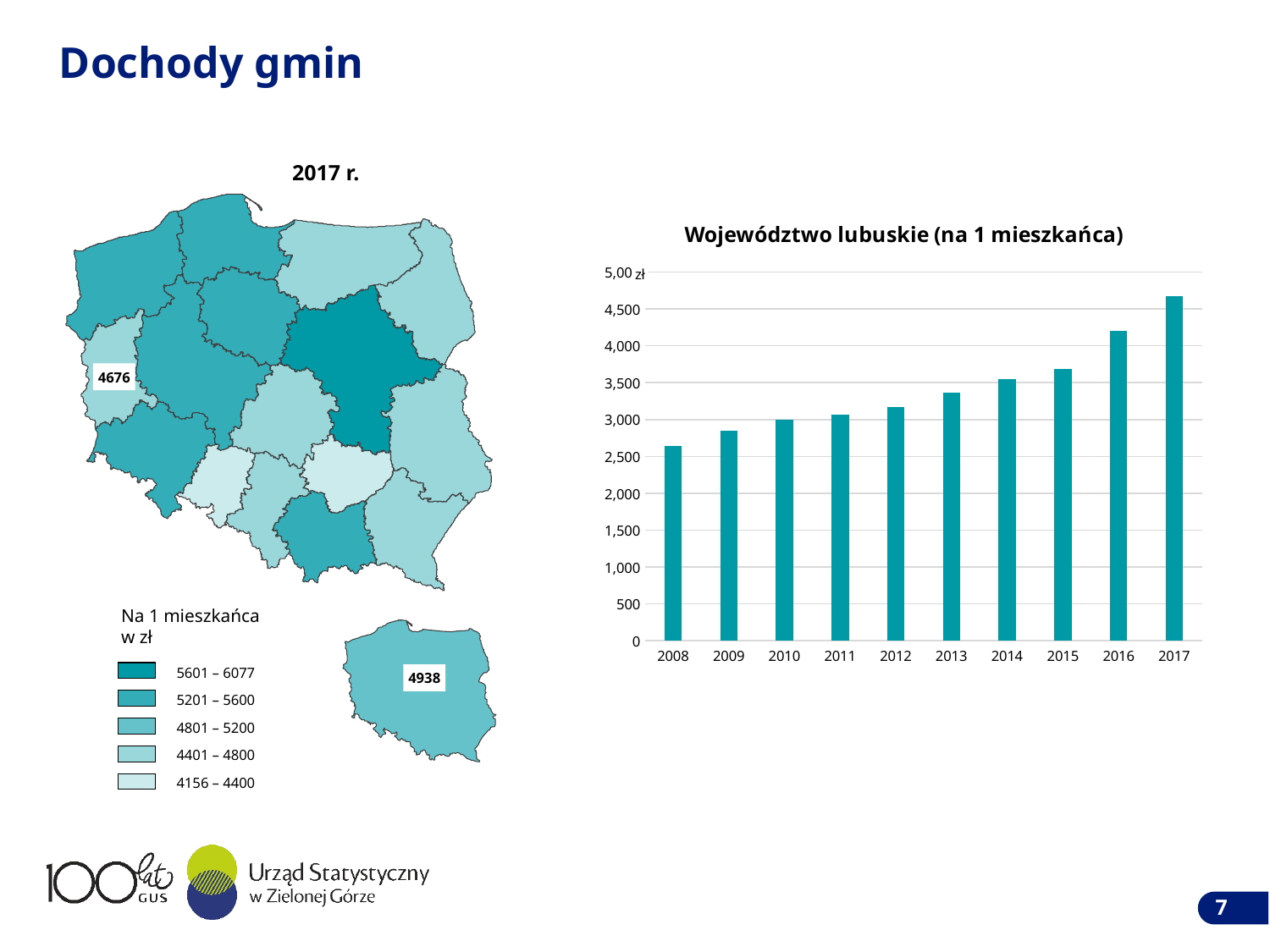
What kind of chart is the 'Województwo lubuskie (na 1 mieszkańca)' chart? bar chart What is the title of the bar chart on the right side of the slide? Województwo lubuskie (na 1 mieszkańca) In the 'Województwo lubuskie (na 1 mieszkańca)' chart, which is larger, the value for 2016 or the value for 2015? 2016 In the 'Województwo lubuskie (na 1 mieszkańca)' chart, is the value for 2013 greater or less than 3,500? less In the 'Województwo lubuskie (na 1 mieszkańca)' chart, which year has the highest value? 2017 In the 'Województwo lubuskie (na 1 mieszkańca)' chart, do the values rise or fall from 2008 to 2017? rise In the 'Województwo lubuskie (na 1 mieszkańca)' chart, which year has the lowest value? 2008 In the 'Województwo lubuskie (na 1 mieszkańca)' chart, is the value for 2008 greater or less than 3,000? less In the 'Województwo lubuskie (na 1 mieszkańca)' chart, is the value for 2017 greater or less than 4,500? greater On the map on the left, what value is printed on the highlighted western voivodeship? 4676 In the 'Województwo lubuskie (na 1 mieszkańca)' chart, how many years are shown on the x axis? 10